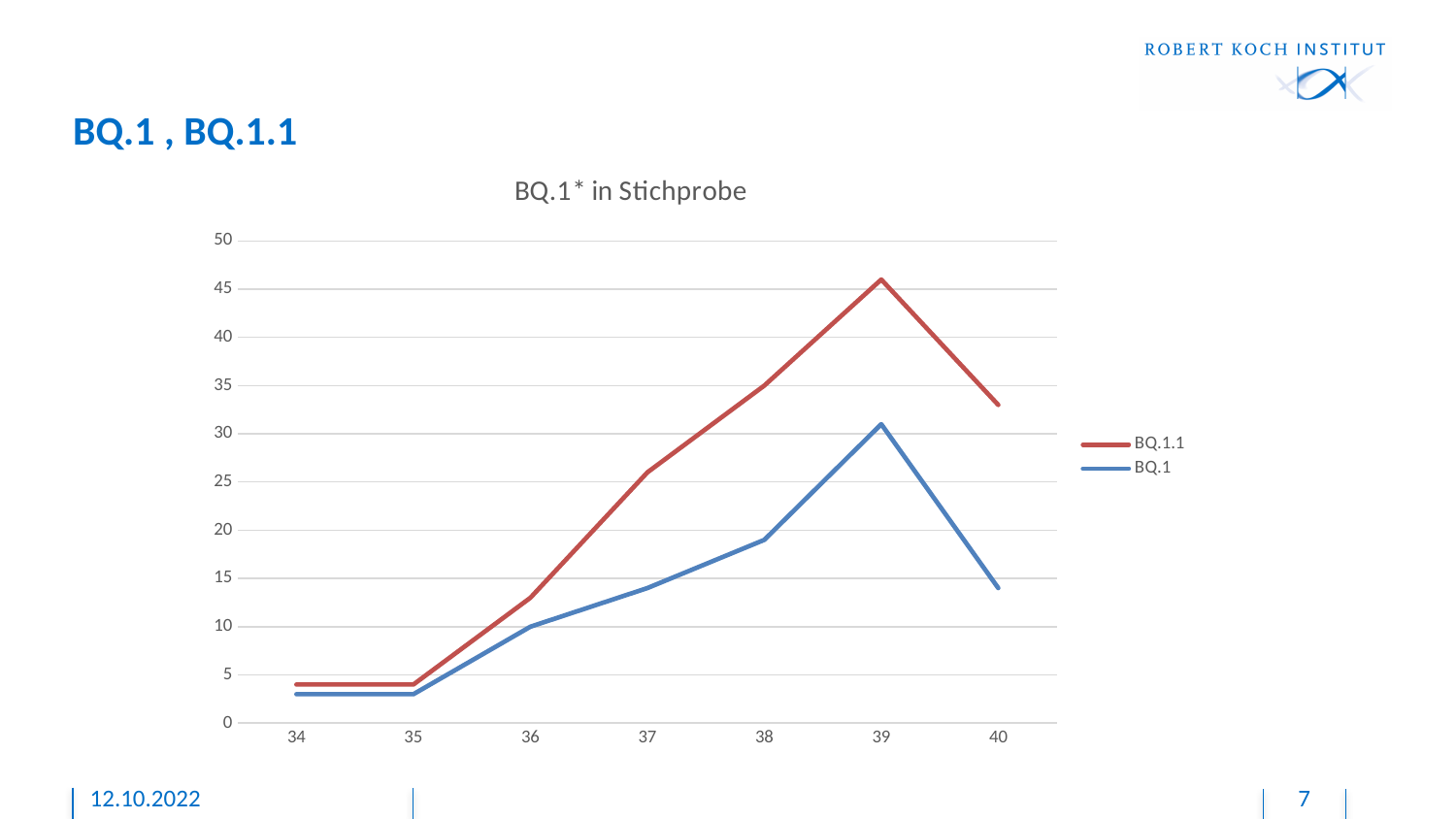
Does the BQ.1 series rise or fall from 34 to 39? rise Is the value for BQ.1.1 at 40 greater or less than 30? greater At x = 39, which series has the larger value, BQ.1.1 or BQ.1? BQ.1.1 Is the value for BQ.1 at 40 greater or less than 20? less How many series does the legend list? 2 How many points are plotted along the x axis for each series? 7 Is the value for BQ.1.1 at 39 greater or less than 40? greater At which x-axis value does the BQ.1.1 series reach its highest point? 39 What is the title of the chart? BQ.1* in Stichprobe What kind of chart is shown on the slide? line chart At which x-axis value does the BQ.1 series reach its highest point? 39